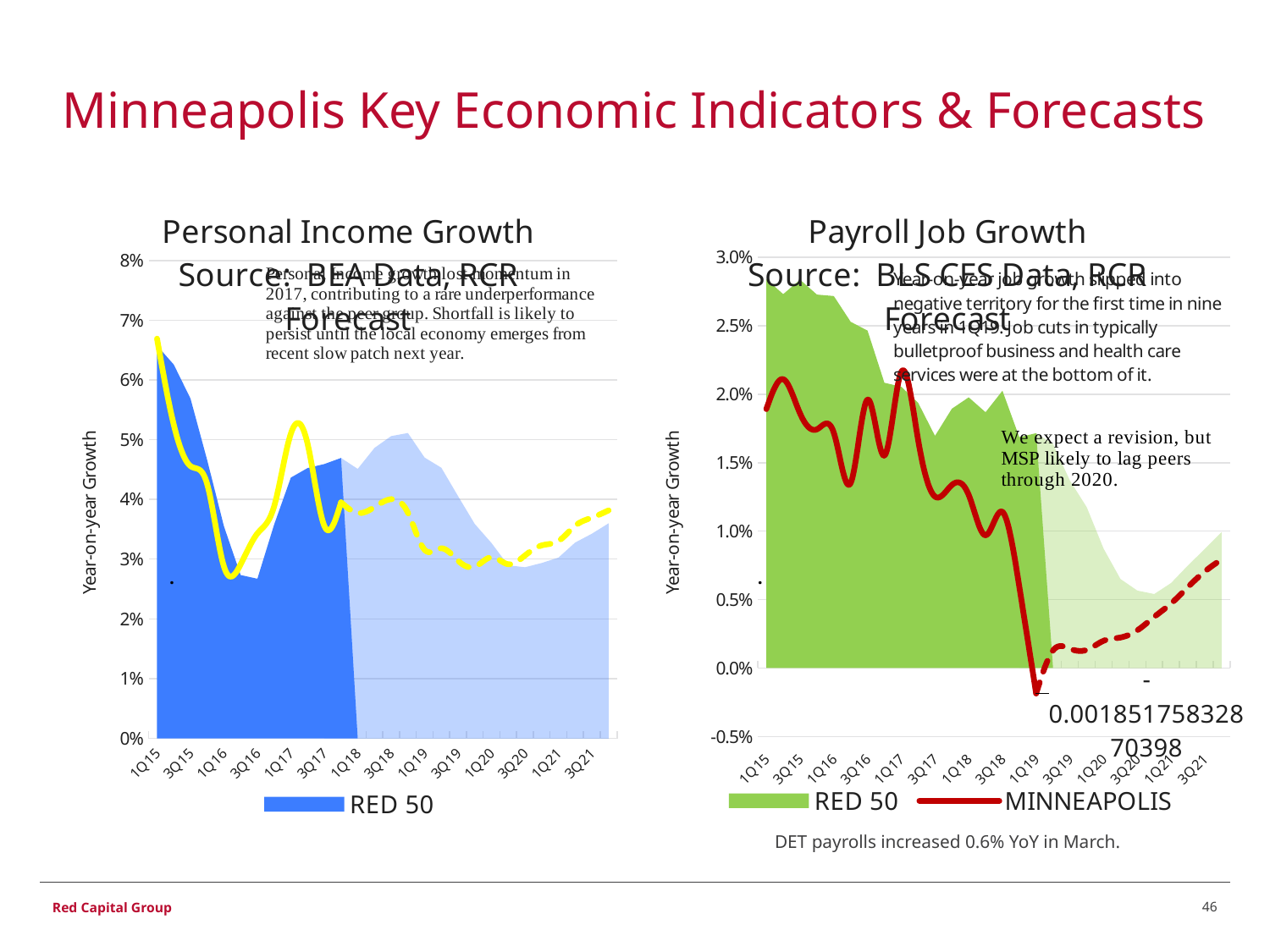
In the Personal Income Growth chart, is the RED 50 value at 1Q15 greater or less than 6%? greater In the Payroll Job Growth chart, which series is drawn as a red line? MINNEAPOLIS In the Payroll Job Growth chart, does the MINNEAPOLIS line generally rise or fall from 1Q15 to 1Q19? fall What kind of chart is the Payroll Job Growth chart? area chart with a line What is the title of the chart on the left side of the slide? Personal Income Growth In the Personal Income Growth chart, how many series does the legend list? 1 In the Payroll Job Growth chart, how many series does the legend list? 2 In the Payroll Job Growth chart, at which quarter does the MINNEAPOLIS line reach its lowest point? 1Q19 In the Personal Income Growth chart, is the RED 50 value at 1Q16 greater or less than 3%? greater In the Payroll Job Growth chart, is the MINNEAPOLIS value at 1Q19 greater or less than 0.0%? less In the Payroll Job Growth chart, at 1Q15, which is larger: RED 50 or MINNEAPOLIS? RED 50